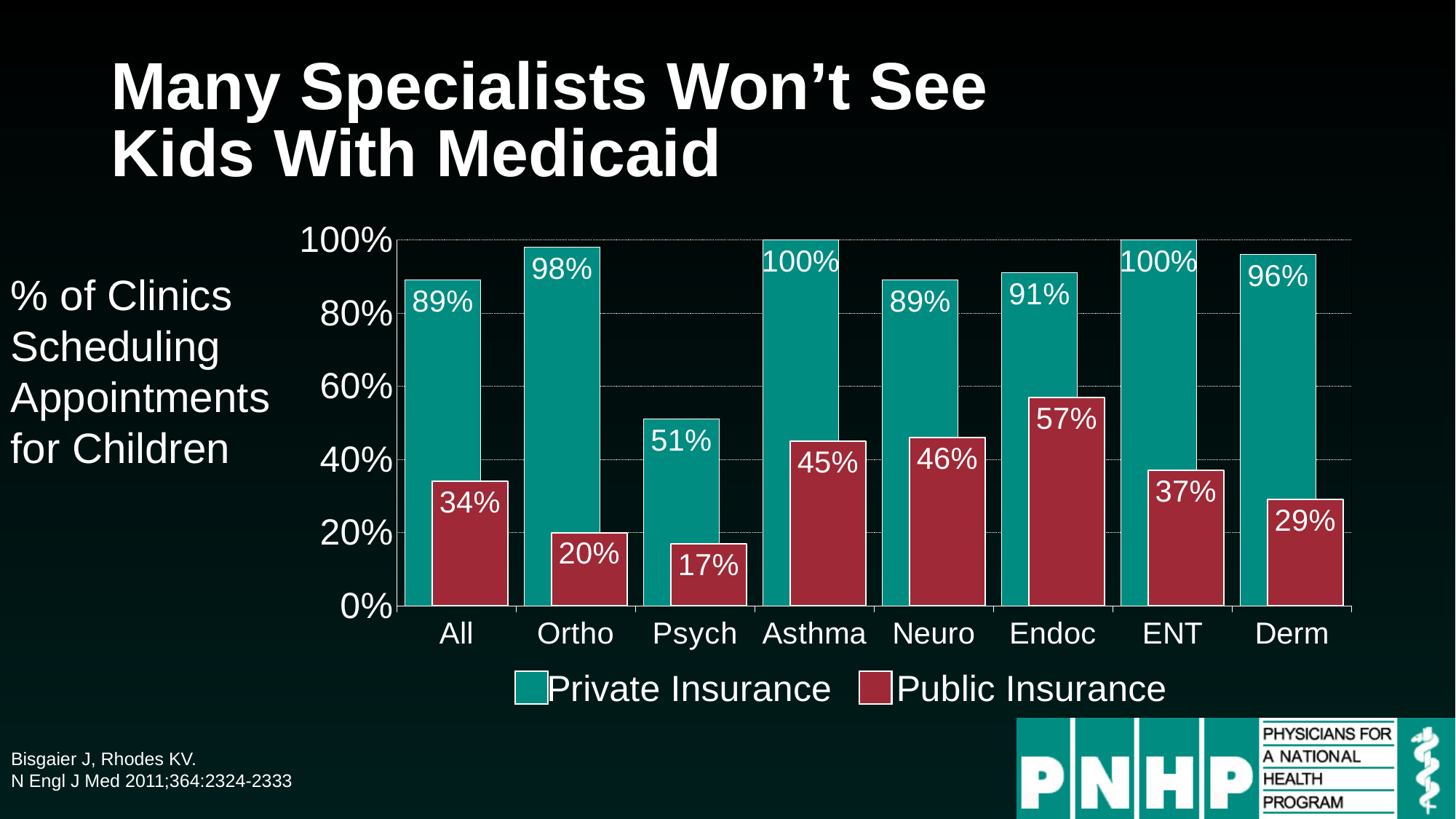
Which category has the highest Public Insurance value? Endoc What does the y axis of the chart measure, according to the label on the left? % of Clinics Scheduling Appointments for Children Which category has the lowest Private Insurance value? Psych How many series does the legend list? 2 What percentage of Psych clinics scheduled appointments for children with Public Insurance? 17% Which category has the lowest Public Insurance value? Psych What is the Public Insurance value for Endoc? 57% What is the difference between the Private Insurance and Public Insurance values for Derm? 67 percentage points Which is larger for Neuro: the Private Insurance value or the Public Insurance value? Private Insurance How many specialty categories are shown on the x axis? 8 What percentage of Ortho clinics scheduled appointments for children with Private Insurance? 98% What kind of chart is shown on the slide? Bar chart